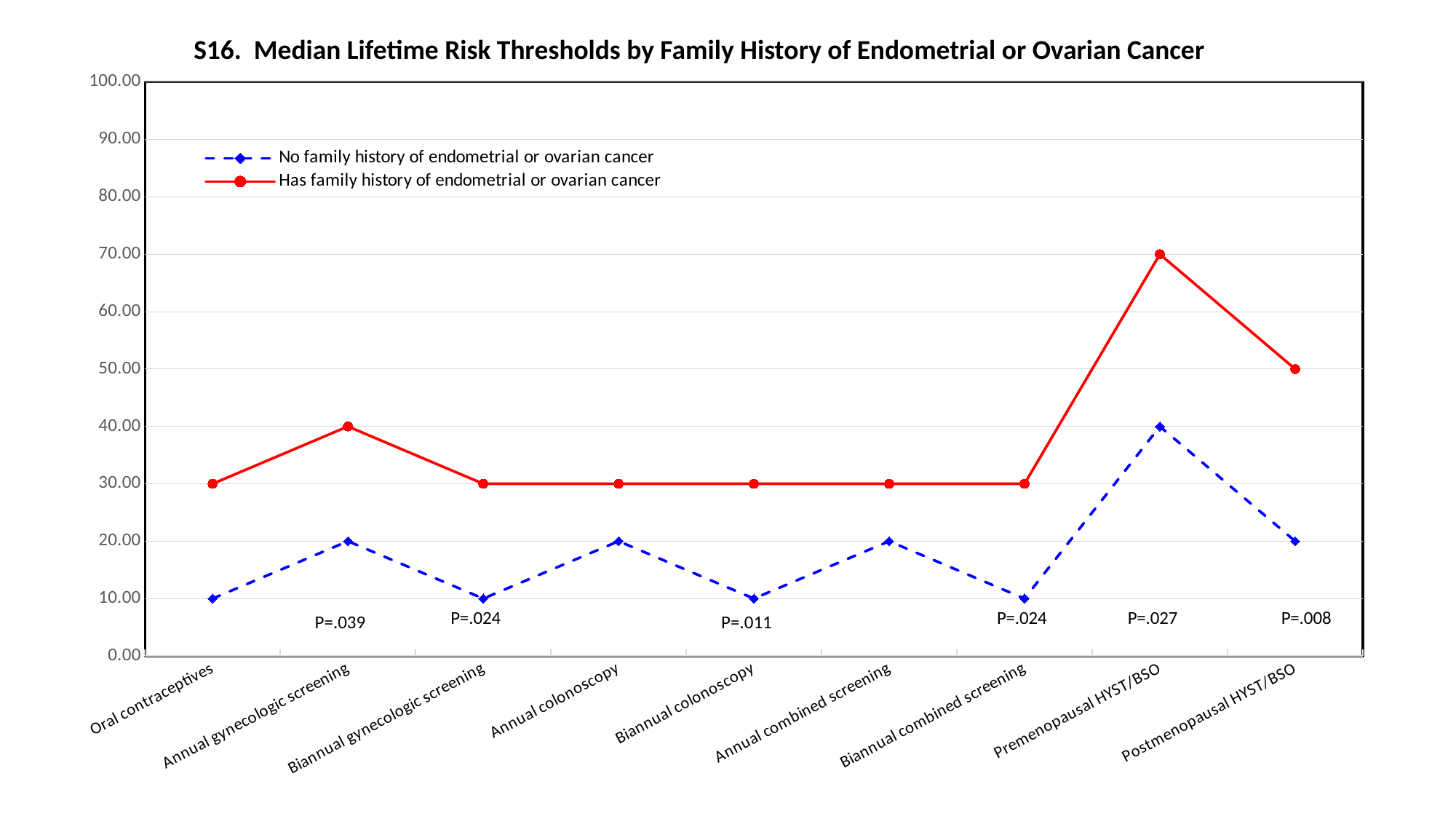
Is the value for 'Has family history of endometrial or ovarian cancer' at Postmenopausal HYST/BSO greater or less than 60.00? less At Postmenopausal HYST/BSO, which series has the larger value? Has family history of endometrial or ovarian cancer How many categories are plotted along the x axis? 9 How many series does the legend list? 2 What is the title of the chart? S16. Median Lifetime Risk Thresholds by Family History of Endometrial or Ovarian Cancer What is the value for 'No family history of endometrial or ovarian cancer' at Premenopausal HYST/BSO? 40.00 What P value is printed beneath the Postmenopausal HYST/BSO category? P=.008 What kind of chart is shown on the slide? line chart What is the difference between the two series at Premenopausal HYST/BSO? 30.00 What is the value for 'Has family history of endometrial or ovarian cancer' at Premenopausal HYST/BSO? 70.00 What is the value for 'Has family history of endometrial or ovarian cancer' at Annual gynecologic screening? 40.00 For which category is the 'Has family history of endometrial or ovarian cancer' series highest? Premenopausal HYST/BSO